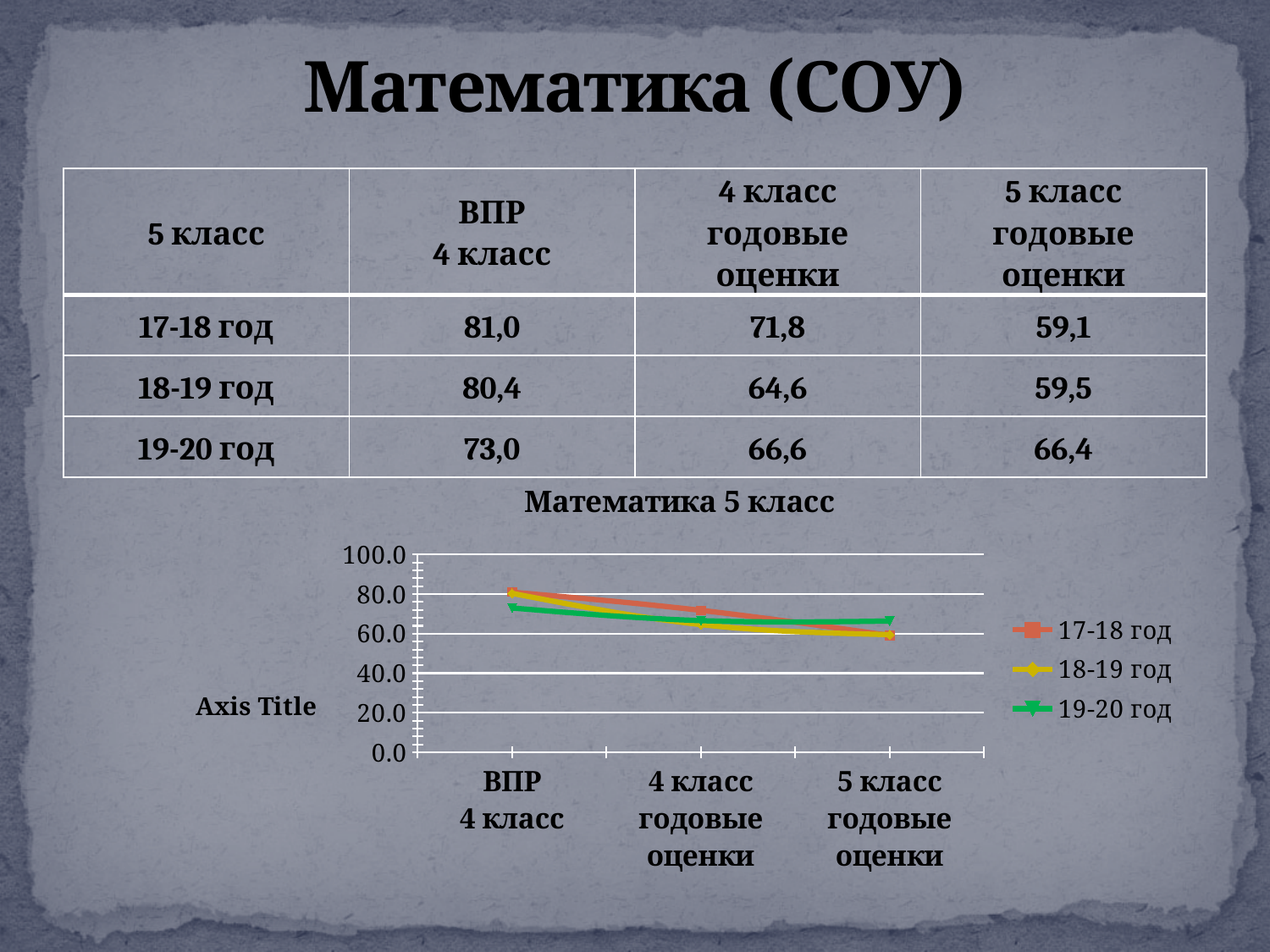
What is the title of the chart? Математика 5 класс Does the 17-18 год line rise or fall from ВПР 4 класс to 5 класс годовые оценки? fall Does the 18-19 год line rise or fall along the x axis? fall Which series has the highest value at 4 класс годовые оценки? 17-18 год What text is shown as the vertical axis title of the chart? Axis Title Is the value for 19-20 год at ВПР 4 класс greater or less than 80? less At ВПР 4 класс, which is larger: the value for 17-18 год or for 19-20 год? 17-18 год How many categories are shown on the x axis of the chart? 3 How many series does the chart legend list? 3 Is the value for 17-18 год at ВПР 4 класс greater or less than 60? greater What kind of chart is shown under the table? line chart Which series has the highest value at 5 класс годовые оценки? 19-20 год